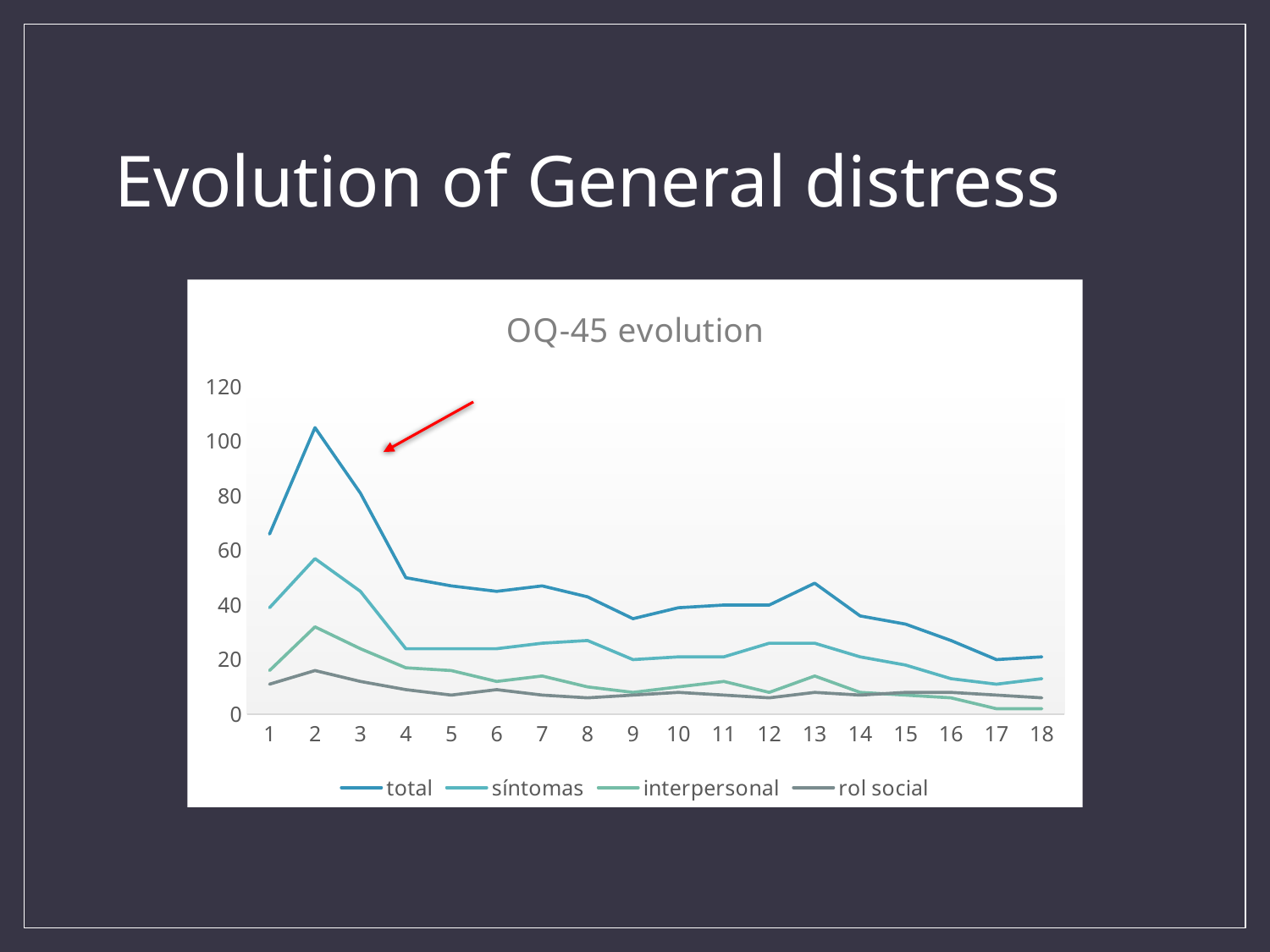
Is the value of the 'total' series at point 17 greater or less than 40? less How many points are plotted along the x axis of the OQ-45 evolution chart? 18 How many series does the legend of the OQ-45 evolution chart list? 4 At which x-axis point does the 'total' series reach its highest value? 2 Which series has the lowest value at point 2? rol social Is the value of the 'total' series at point 1 greater or less than 60? greater Does the 'total' series rise or fall between points 2 and 4? fall What kind of chart is shown on the slide? line chart What is the title of the chart on the slide? OQ-45 evolution At point 2, which series has the larger value, 'total' or 'síntomas'? total Is the value of the 'total' series at point 2 greater or less than 100? greater